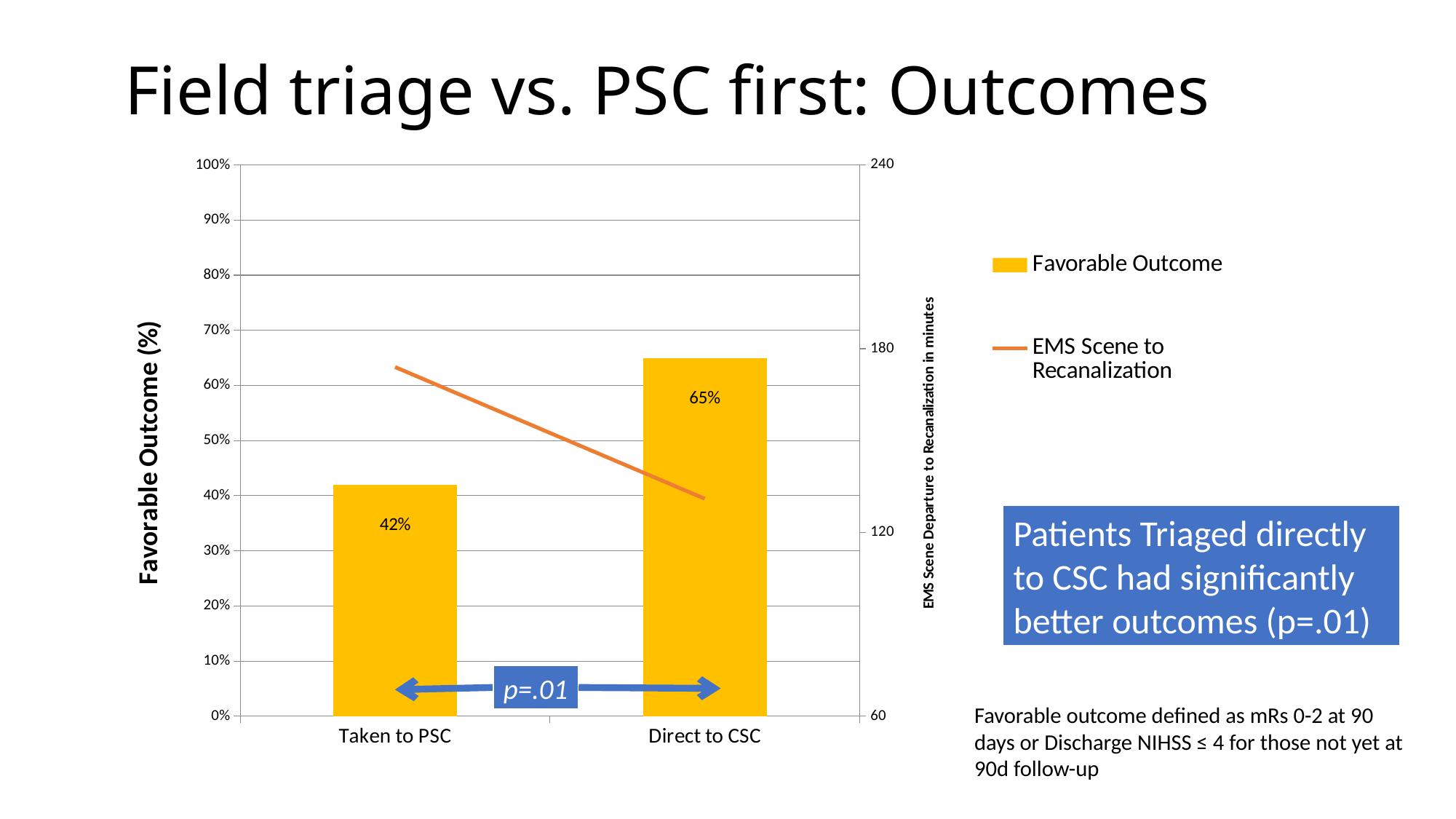
Is the EMS Scene to Recanalization value for Taken to PSC greater or less than 120 minutes? greater How many categories are shown on the x axis? 2 Which category has the higher Favorable Outcome? Direct to CSC Which category has the lower Favorable Outcome? Taken to PSC What is the difference in Favorable Outcome between Direct to CSC and Taken to PSC? 23% Is the Favorable Outcome for Taken to PSC greater or less than 50%? less What is the Favorable Outcome value for Taken to PSC? 42% What colour are the Favorable Outcome bars? Yellow/orange What is the Favorable Outcome value for Direct to CSC? 65% Does the EMS Scene to Recanalization line rise or fall from Taken to PSC to Direct to CSC? fall How many series does the legend list? 2 Is the EMS Scene to Recanalization value for Direct to CSC greater or less than 180 minutes? less